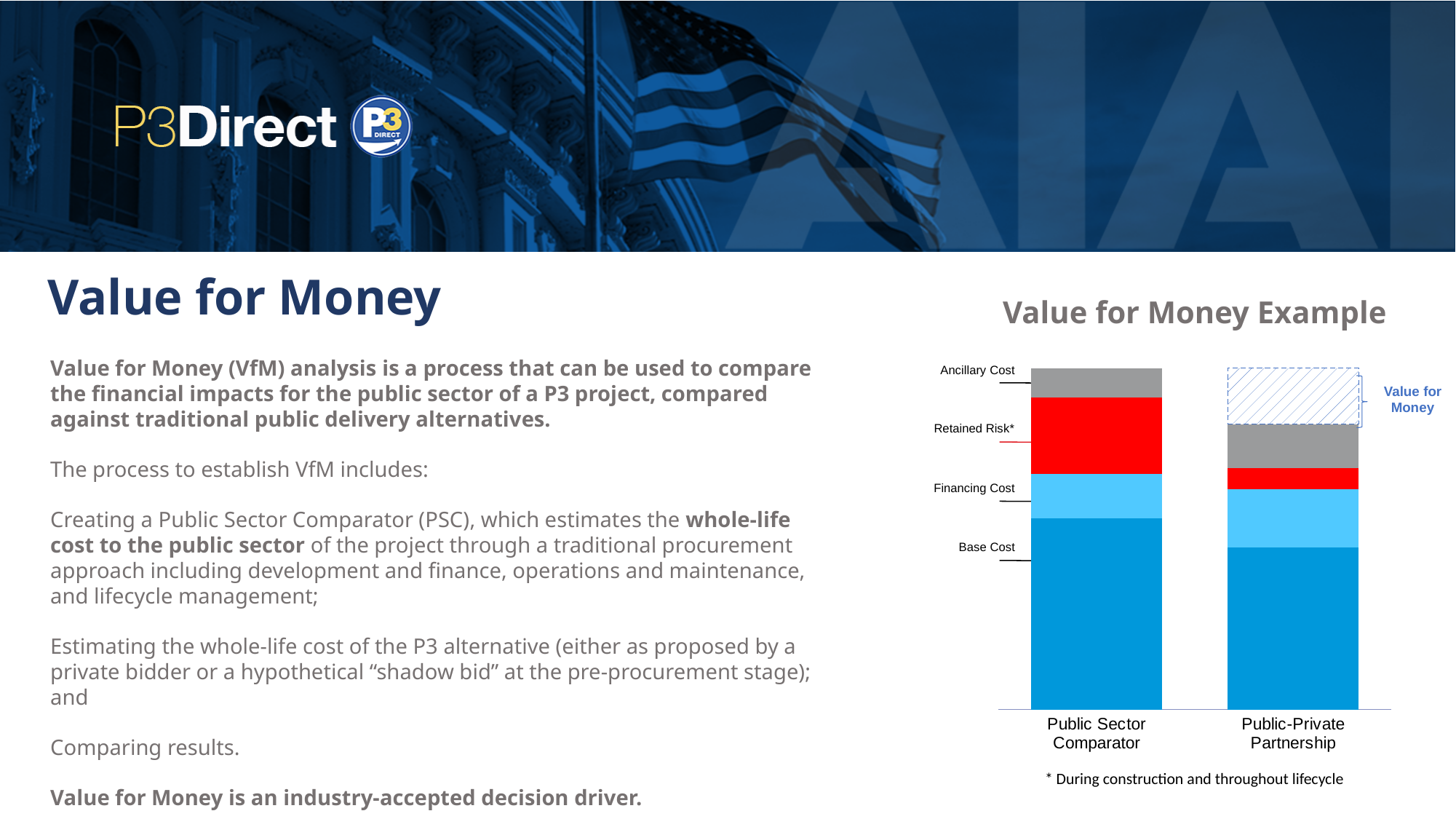
What does the hatched area at the top of the Public-Private Partnership bar represent in the "Value for Money Example" chart? Value for Money What kind of chart is shown under the title "Value for Money Example"? Stacked bar chart In the "Value for Money Example" chart, which category has the larger Retained Risk segment? Public Sector Comparator What are the two categories on the x axis of the "Value for Money Example" chart? Public Sector Comparator and Public-Private Partnership How many bars (categories) are plotted in the "Value for Money Example" chart? 2 Which cost component is shown in red in the "Value for Money Example" chart? Retained Risk* In the "Value for Money Example" chart, which category has the larger Base Cost segment? Public Sector Comparator In the "Value for Money Example" chart, which category has the larger Ancillary Cost segment? Public-Private Partnership How many cost components are labelled on the left of the "Value for Money Example" chart? 4